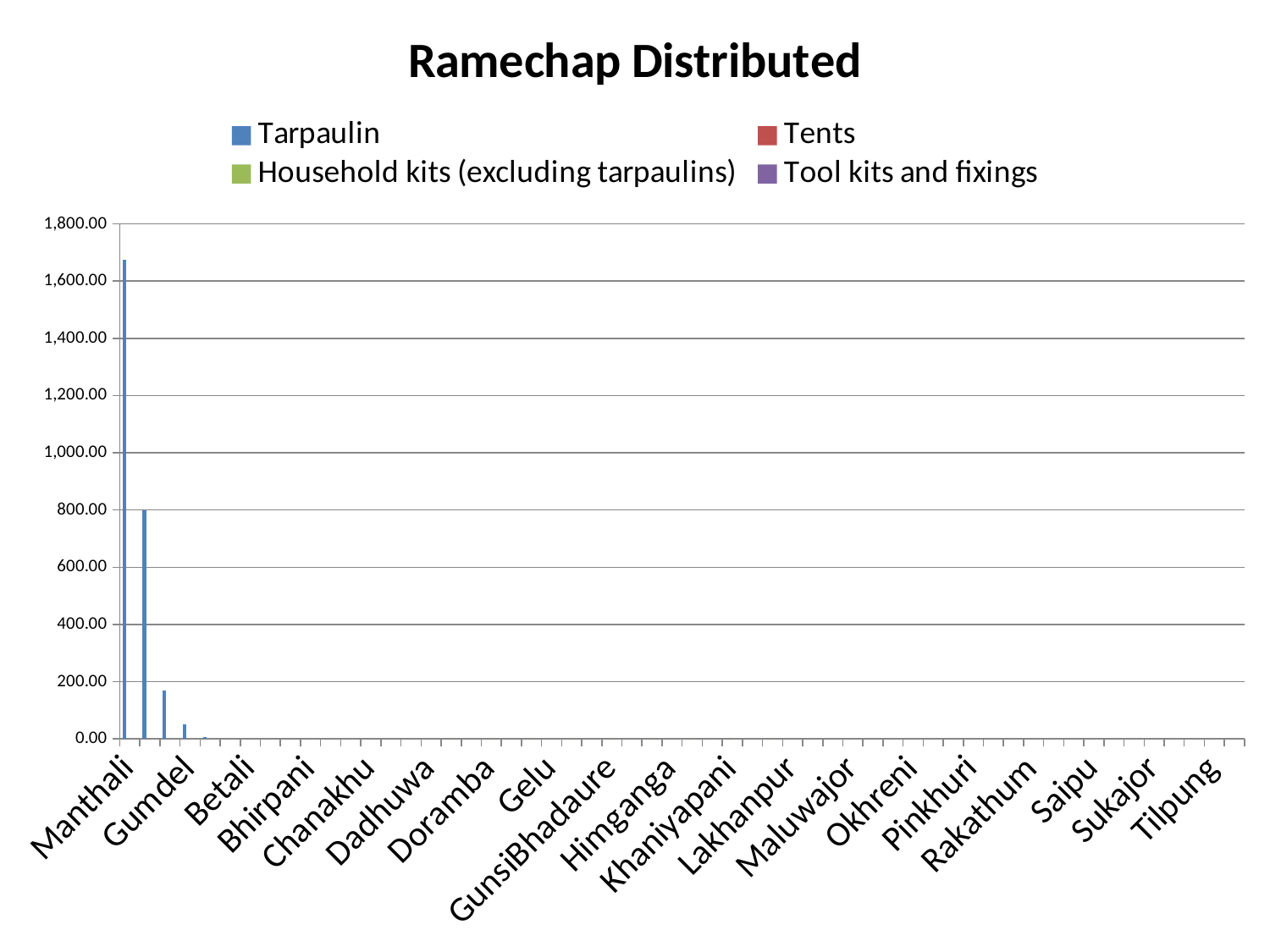
Which has a larger Tarpaulin value, Manthali or Gumdel? Manthali Is the Tarpaulin value for Manthali greater or less than 1,600? greater Is the Tarpaulin value for Gumdel greater or less than 200? less Which category has the highest Tarpaulin value? Manthali What kind of chart is shown on the slide? bar chart What is the highest value shown on the vertical axis? 1,800.00 How many series does the legend list? 4 Is the Tarpaulin value for Gumdel greater or less than 100? less Do the Tarpaulin values rise or fall moving from Manthali to Gumdel along the x axis? fall What is the title of the chart? Ramechap Distributed